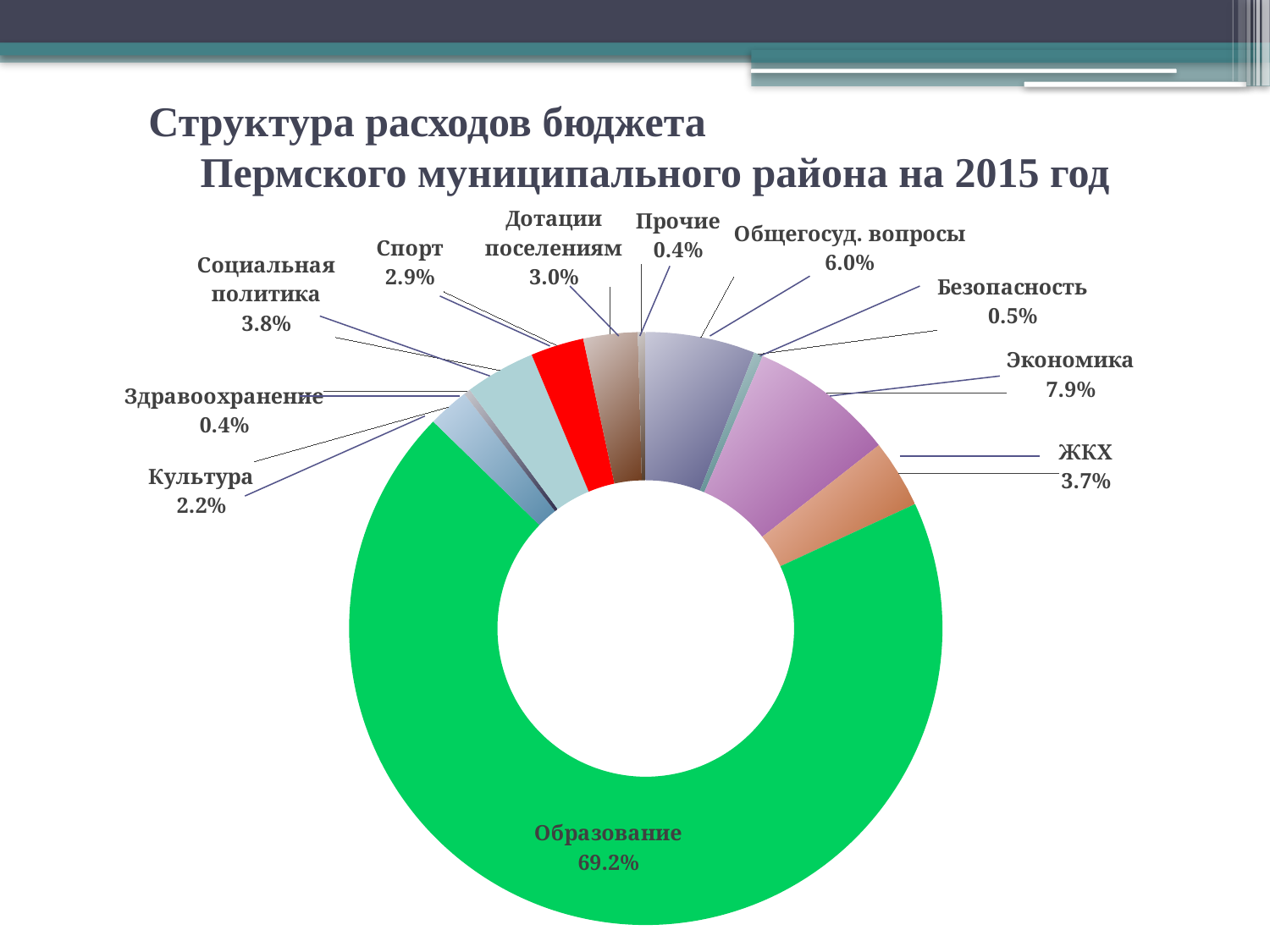
What type of chart is shown on the slide? Doughnut (pie) chart What share of the budget expenditure goes to Образование? 69.2% What percentage is shown for Общегосуд. вопросы? 6.0% What share is labelled for Безопасность? 0.5% Which category has the largest share of the chart? Образование What is the title of the slide? Структура расходов бюджета Пермского муниципального района на 2015 год What is the difference between the shares of Экономика and Общегосуд. вопросы? 1.9% What is the value for ЖКХ? 3.7% How many categories are shown in the chart? 11 What is the value shown for Экономика? 7.9% Which is larger, Спорт or Дотации поселениям? Дотации поселениям Which is larger, Социальная политика or ЖКХ? Социальная политика